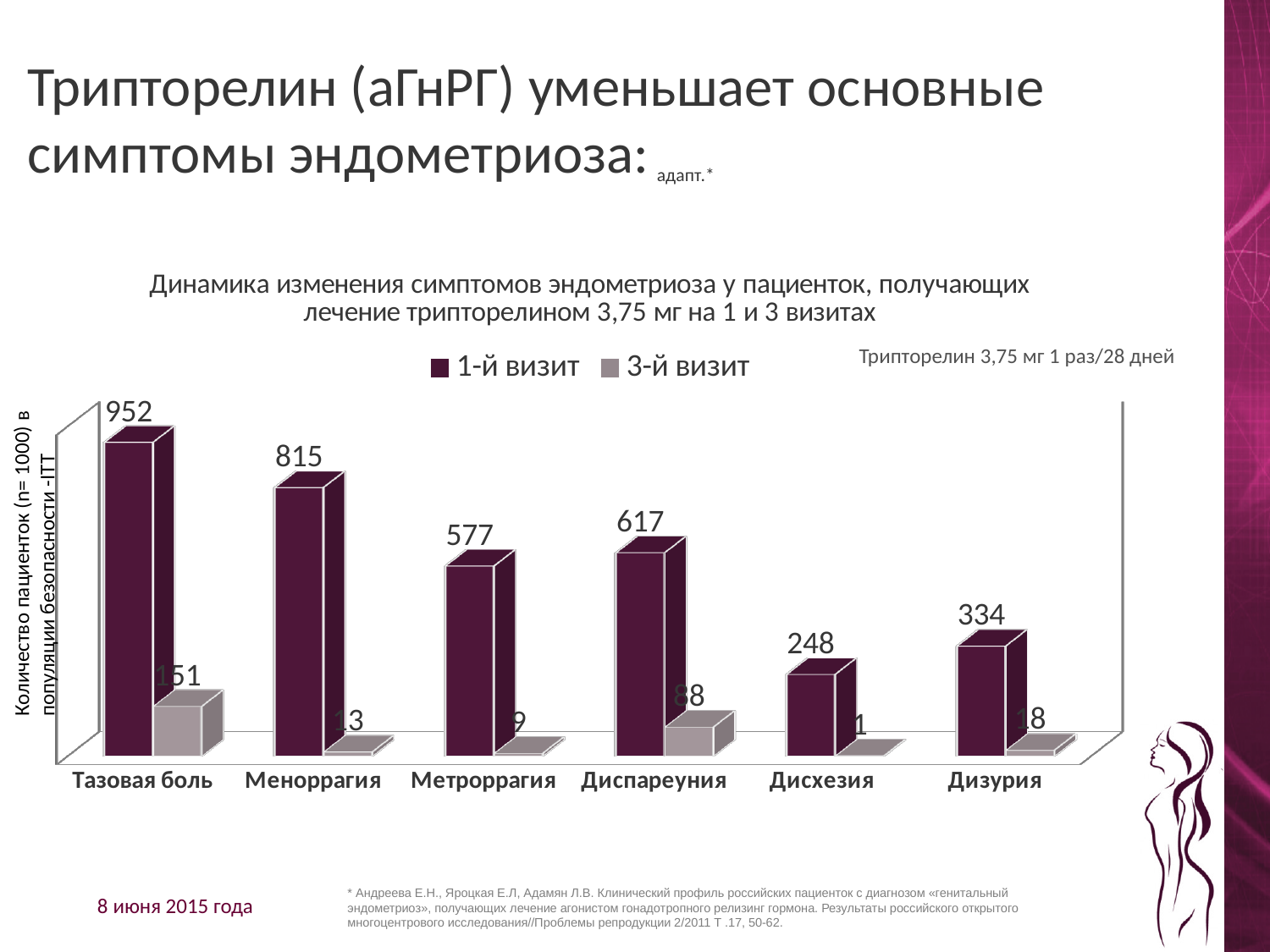
What is the value for Дисхезия in the 3-й визит series? 1 Which category has the highest value in the 1-й визит series? Тазовая боль What are the two series named in the legend? 1-й визит and 3-й визит What is the value for Диспареуния in the 3-й визит series? 88 Which category has the lowest value in the 3-й визит series? Дисхезия What is the difference between the 1-й визит and 3-й визит values for Меноррагия? 802 What is the value for Дизурия in the 1-й визит series? 334 How many categories are shown on the x axis? 6 What is the value for Тазовая боль in the 1-й визит series? 952 Which is larger in the 1-й визит series: Метроррагия or Диспареуния? Диспареуния What kind of chart is shown on the slide? bar chart How many series does the legend list? 2